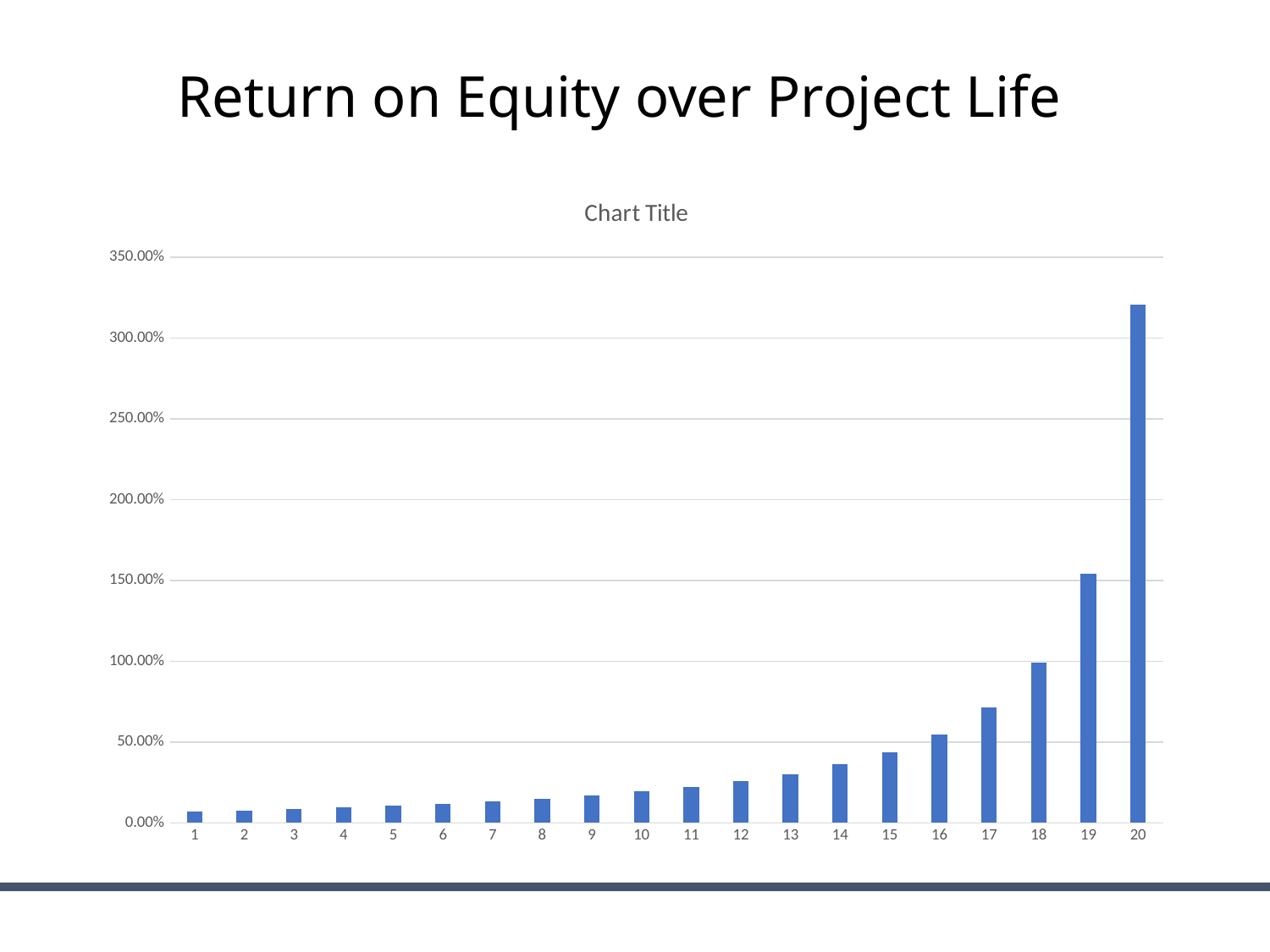
What is the title printed above the chart area? Chart Title Is the value for category 19 greater or less than 100.00%? greater Is the value for category 20 greater or less than 300.00%? greater How many categories are plotted along the x axis? 20 Is the value for category 18 greater or less than 150.00%? less Which is larger, the value for category 19 or the value for category 20? 20 Do the values generally rise or fall from category 1 to category 20? rise What kind of chart is shown on the slide? bar chart Which is larger, the value for category 5 or the value for category 15? 15 Which category has the highest value? 20